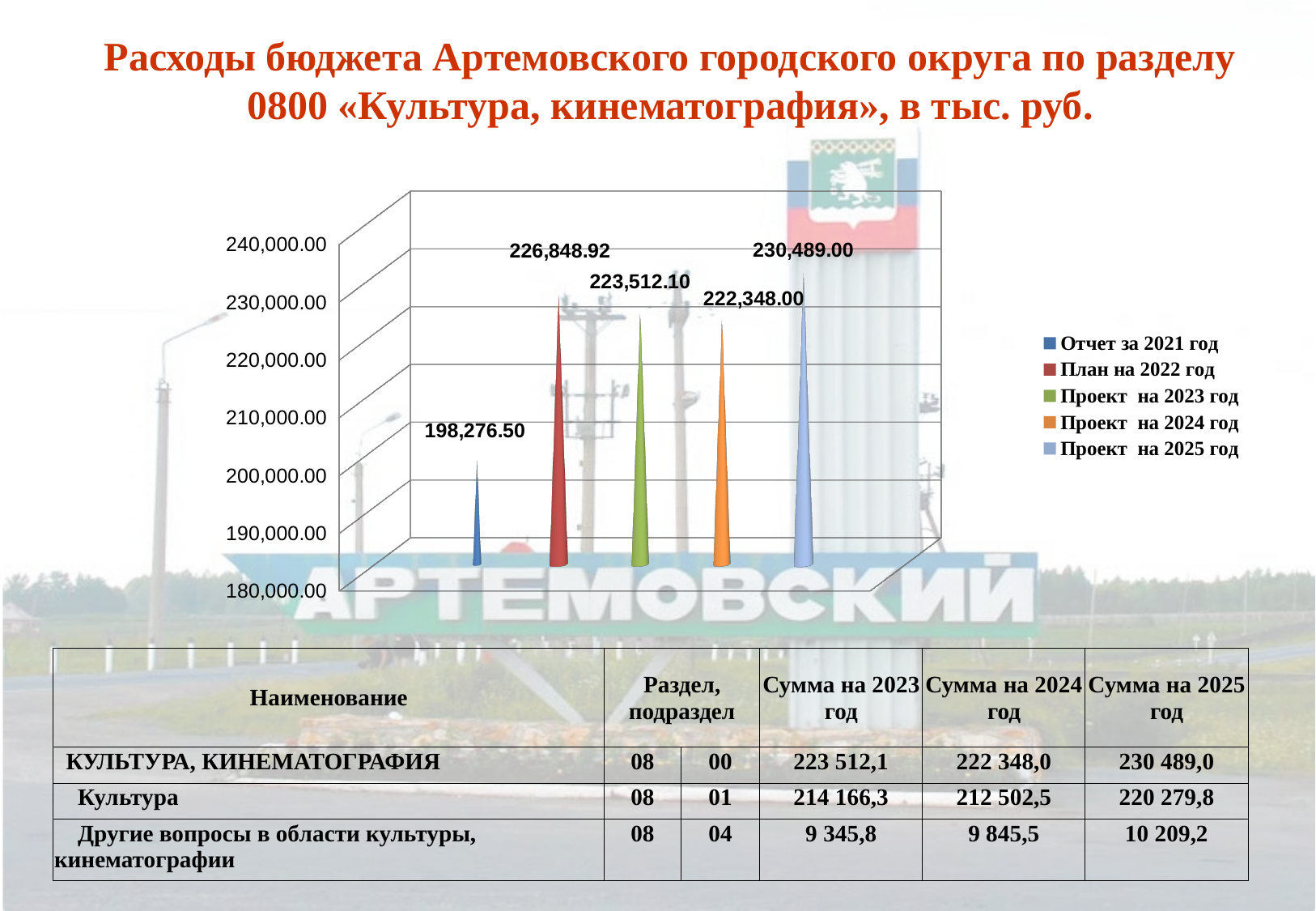
Which legend entry is shown in green? Проект на 2023 год What is the value for «План на 2022 год» on the chart? 226,848.92 Which series has the highest value on the chart? Проект на 2025 год What kind of chart is shown on the slide? bar chart What is the value for «Проект на 2023 год» on the chart? 223,512.10 Is the value for «Отчет за 2021 год» greater or less than 200,000.00? less What is the value for «Отчет за 2021 год» on the chart? 198,276.50 What is the difference between the values for «Проект на 2025 год» and «Отчет за 2021 год»? 32,212.50 Which is larger: the value for «План на 2022 год» or the value for «Проект на 2024 год»? План на 2022 год Which series has the lowest value on the chart? Отчет за 2021 год How many series does the chart legend list? 5 What is the value for «Проект на 2025 год» on the chart? 230,489.00